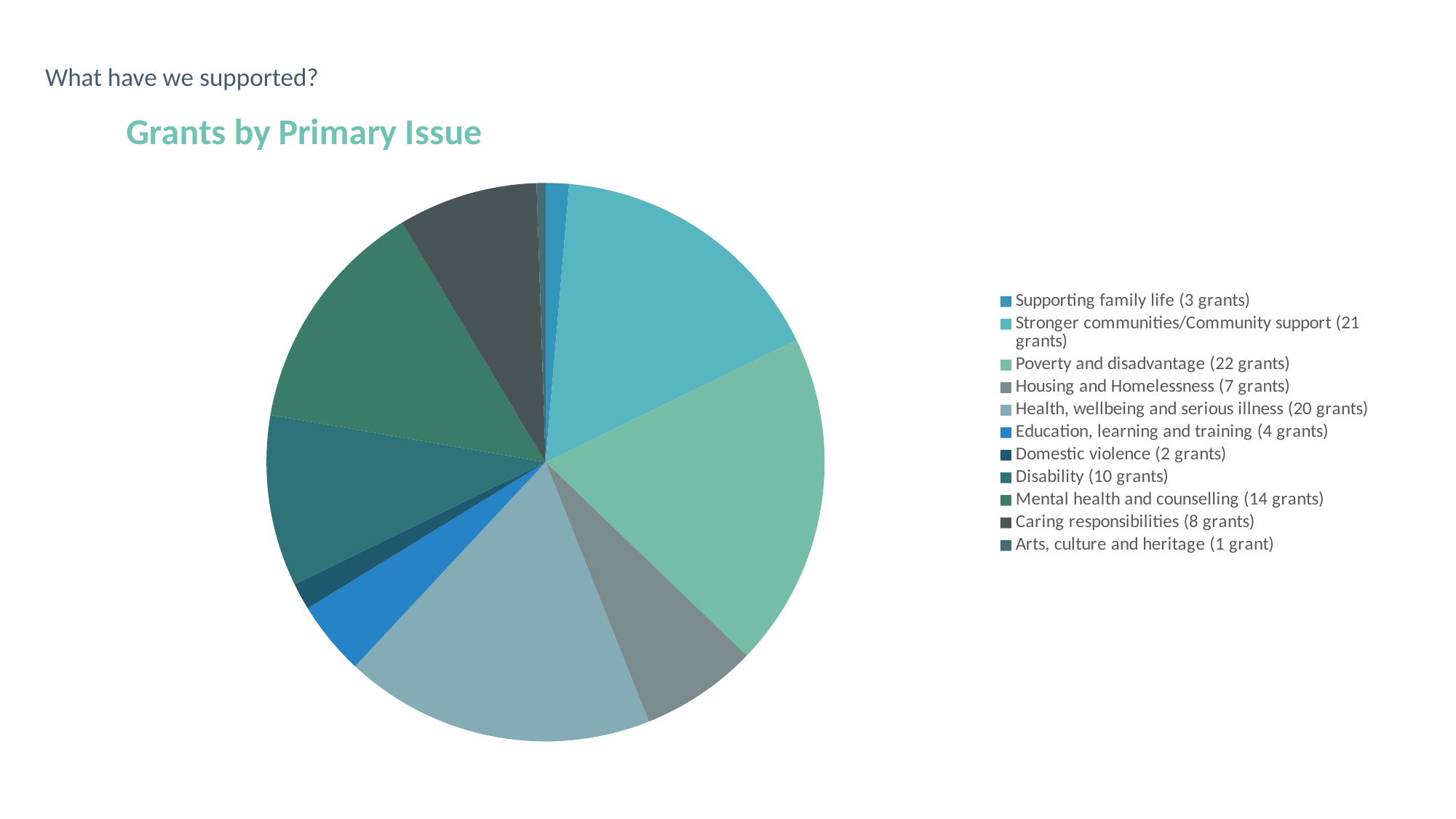
Which primary issue received the most grants? Poverty and disadvantage What type of chart is shown on the slide? Pie chart How many grants were made for Poverty and disadvantage? 22 grants What is the total number of grants across all primary issues shown? 112 Which received more grants: Housing and Homelessness or Education, learning and training? Housing and Homelessness How many grants were made for Health, wellbeing and serious illness? 20 grants What is the title of the chart? Grants by Primary Issue How many primary issue categories are shown in the pie chart? 11 How many more grants did Mental health and counselling receive than Caring responsibilities? 6 How many grants were made for Disability? 10 grants Which primary issue received the fewest grants? Arts, culture and heritage How many grants were made for Domestic violence? 2 grants